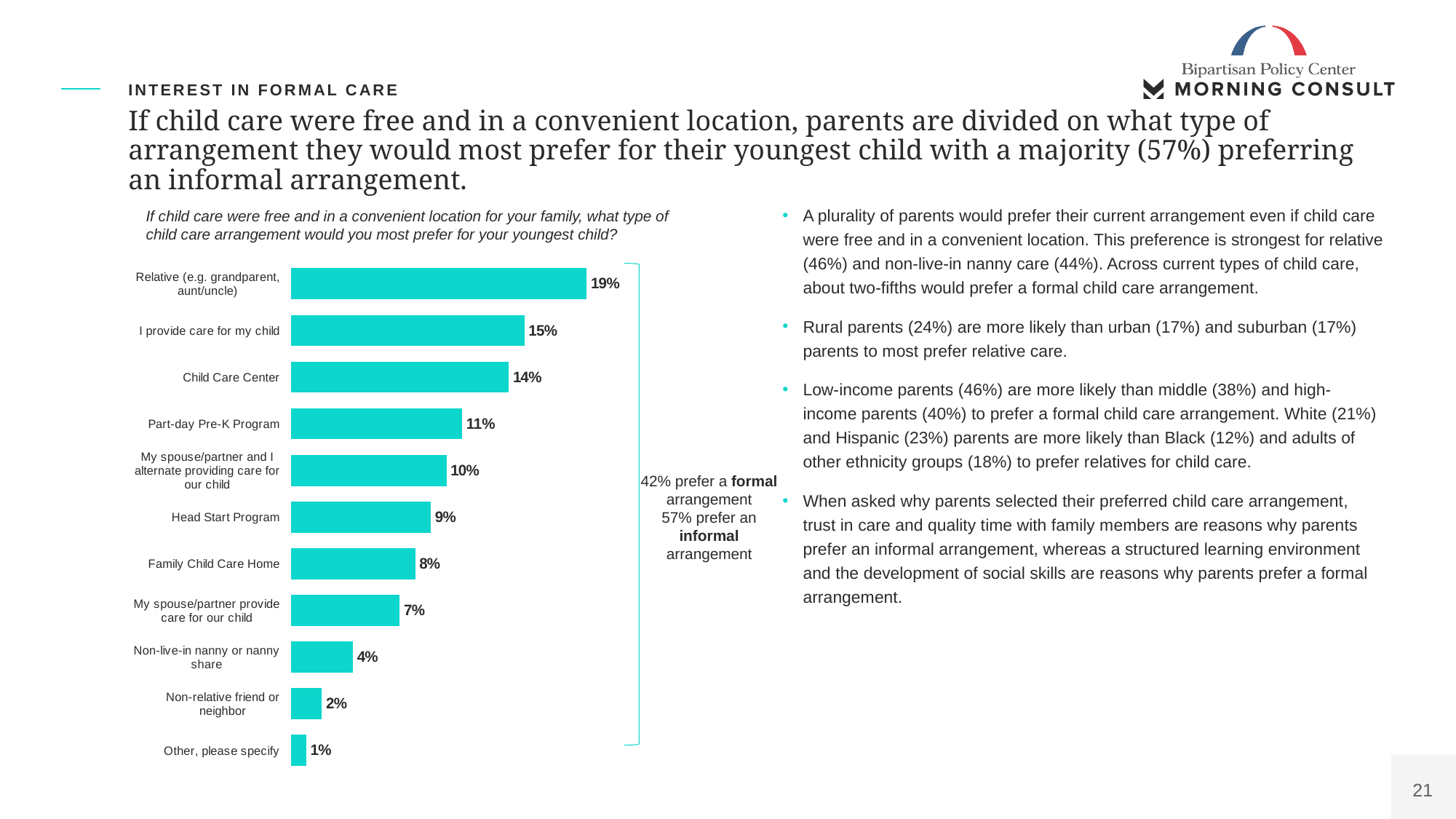
What is the difference in percentage points between 'I provide care for my child' and 'Part-day Pre-K Program'? 4 percentage points What percentage of parents would most prefer a Head Start Program? 9% According to the annotation next to the chart, what percentage of parents prefer an informal arrangement? 57% According to the annotation next to the chart, what percentage of parents prefer a formal arrangement? 42% What percentage of parents would most prefer a Child Care Center? 14% What percentage of parents would most prefer a non-live-in nanny or nanny share? 4% Which child care arrangement has the highest share of parents preferring it? Relative (e.g. grandparent, aunt/uncle) How many child care arrangement categories are shown in the chart? 11 What type of chart is used to show the preferred child care arrangements? Bar chart Which child care arrangement has the lowest share of parents preferring it? Other, please specify What percentage of parents would most prefer a relative (e.g. grandparent, aunt/uncle) to care for their youngest child? 19% Which is preferred by more parents: Family Child Care Home or Part-day Pre-K Program? Part-day Pre-K Program